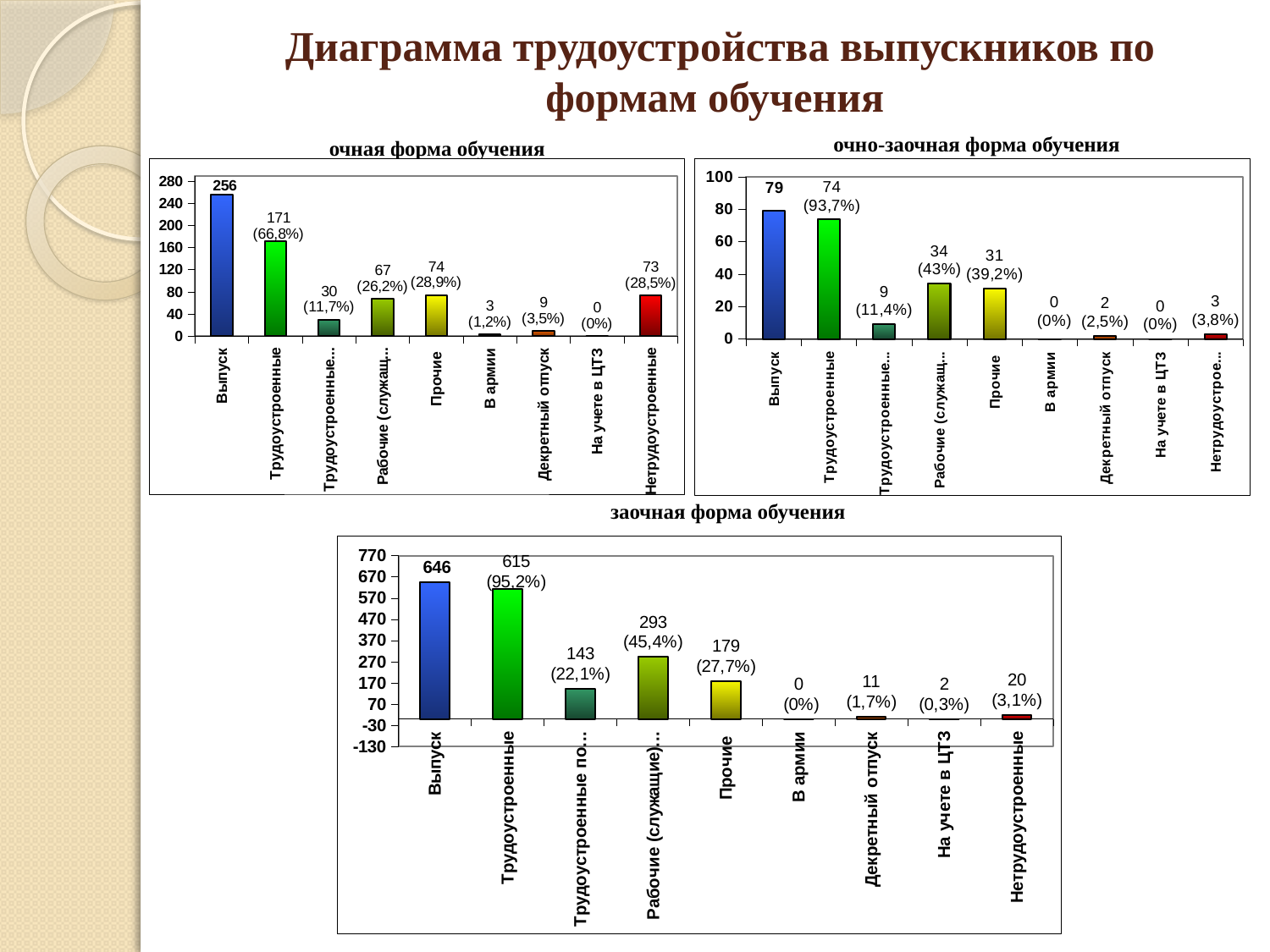
In the chart titled "очно-заочная форма обучения", which is larger: Рабочие (служащ...) or Прочие? Рабочие (служащ...) In the chart titled "очно-заочная форма обучения", what is the value for Трудоустроенные? 74 What type of chart is the chart titled "очная форма обучения"? Bar chart In the chart titled "заочная форма обучения", what is the difference between the values for Рабочие (служащие)... and Прочие? 114 In the chart titled "заочная форма обучения", what percentage is shown for Рабочие (служащие)...? 45,4% In the chart titled "заочная форма обучения", what is the value for Выпуск? 646 In the chart titled "очная форма обучения", what is the value for Выпуск? 256 In the chart titled "очная форма обучения", what is the value for Прочие? 74 In the chart titled "очно-заочная форма обучения", what is the difference between the values for Выпуск and Трудоустроенные? 5 How many categories are shown on the x axis of the chart titled "заочная форма обучения"? 9 In the chart titled "очная форма обучения", what percentage is shown for Трудоустроенные? 66,8% In the chart titled "очная форма обучения", which category has the lowest value? На учете в ЦТЗ